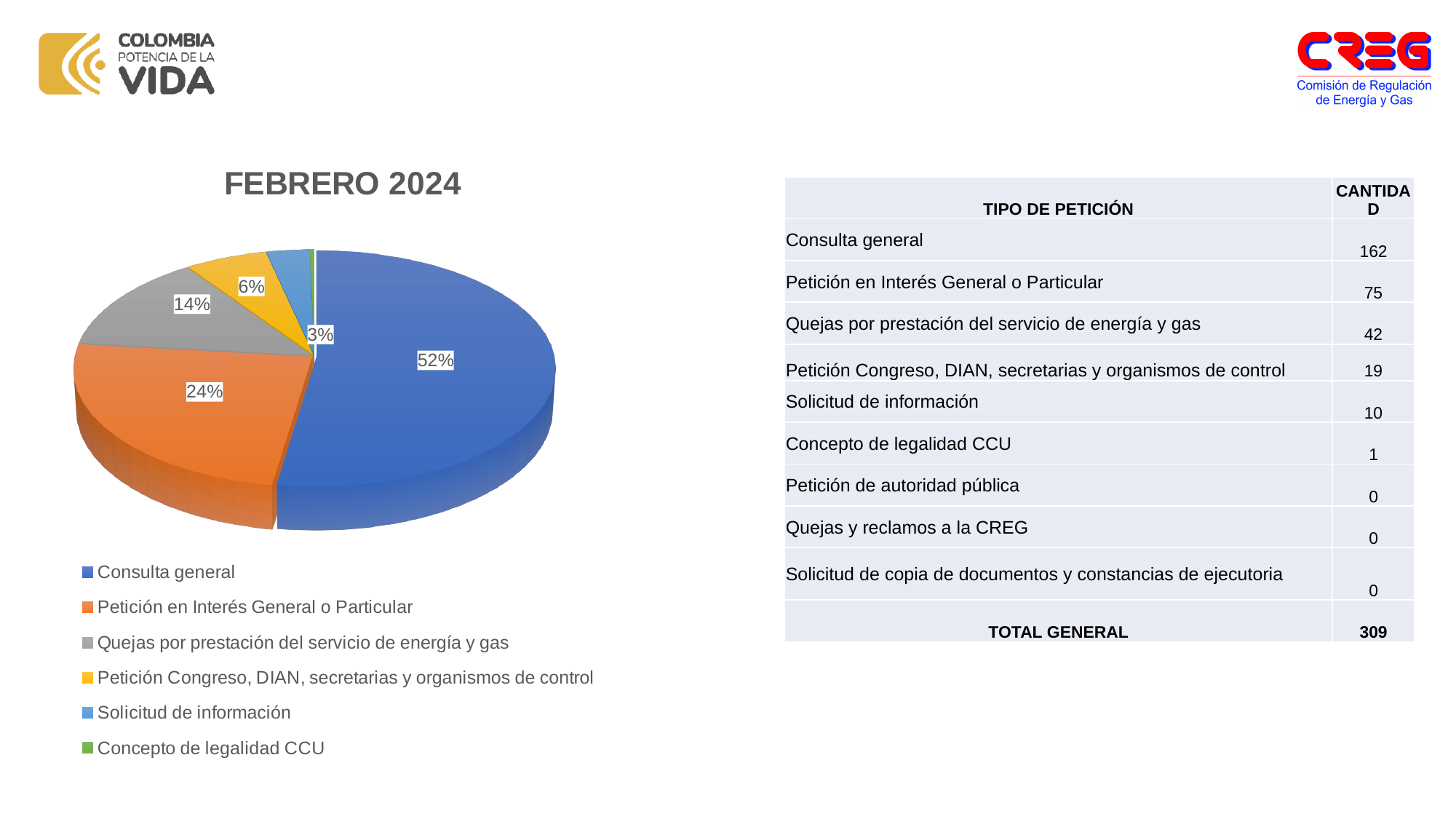
What is the difference in percentage points between the Consulta general slice and the Petición en Interés General o Particular slice? 28 Which slice is larger: Quejas por prestación del servicio de energía y gas or Solicitud de información? Quejas por prestación del servicio de energía y gas What share of the pie does Petición Congreso, DIAN, secretarias y organismos de control represent? 6% What share of the pie does Solicitud de información represent? 3% Which category has the largest slice of the pie? Consulta general How many categories does the pie chart's legend list? 6 What share of the pie does Consulta general represent? 52% What is the title of the pie chart? FEBRERO 2024 Which category has the smallest slice of the pie? Concepto de legalidad CCU What kind of chart is shown on the slide? pie chart